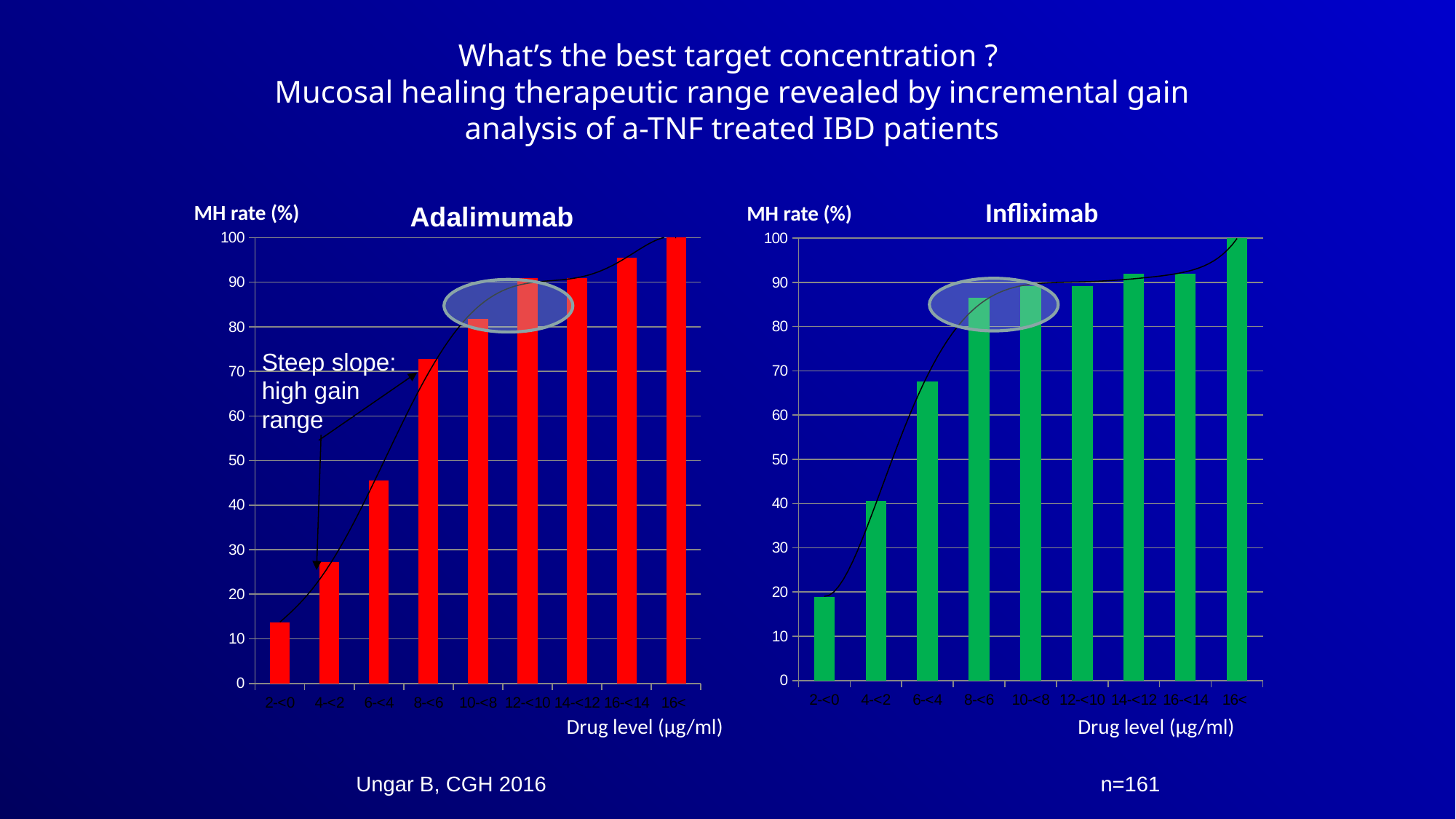
On the Infliximab chart, is the MH rate for the 8-<6 drug level greater or less than 80? greater On the Infliximab chart, what is the MH rate (%) for the 16< drug level? 100 On the Adalimumab chart, is the MH rate for the 2-<0 drug level greater or less than 20? less How many drug level categories are shown on the Infliximab chart? 9 On the Adalimumab chart, is the MH rate for the 8-<6 drug level greater or less than 60? greater On the Adalimumab chart, which drug level category has the highest MH rate? 16< What kind of chart is the Adalimumab chart? bar chart On the Infliximab chart, do the MH rates rise or fall as the drug level increases along the x axis? rise On the Adalimumab chart, which has the higher MH rate: the 6-<4 or the 8-<6 drug level? 8-<6 On the Adalimumab chart, what is the MH rate (%) for the 16< drug level? 100 On the Infliximab chart, which drug level category has the lowest MH rate? 2-<0